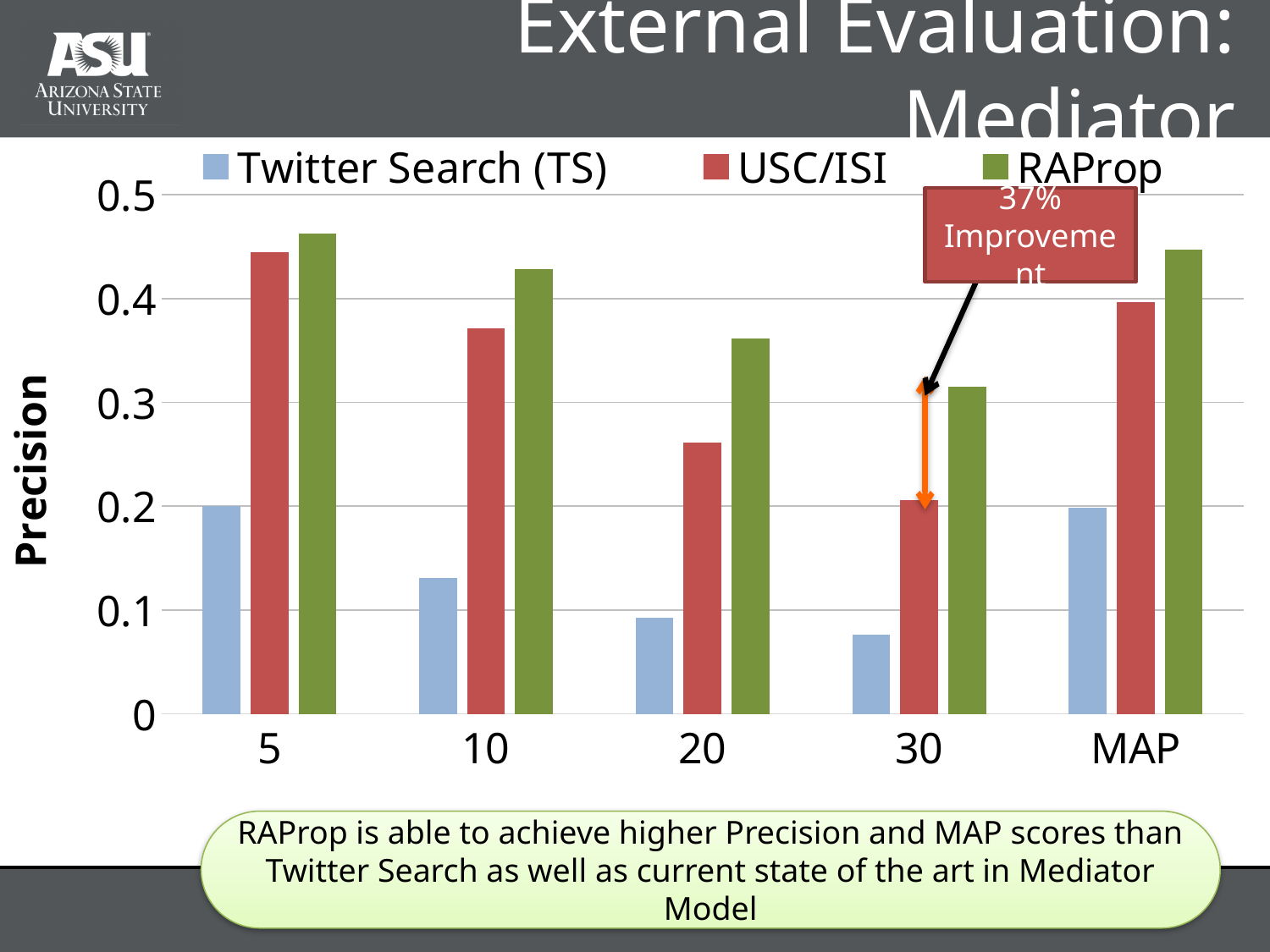
How many categories are shown along the x axis? 5 At which category is the Twitter Search (TS) bar lowest? 30 Which series has the lowest bar in the 20 category? Twitter Search (TS) Is the Twitter Search (TS) value at 30 greater or less than 0.1? less What is the label of the y axis? Precision Is the RAProp value at 20 greater or less than 0.3? greater Which series has the highest bar in the 10 category? RAProp How many series does the legend list? 3 What kind of chart is shown on the slide? bar chart Which is larger: the USC/ISI value at 20 or the RAProp value at 20? RAProp Do the Twitter Search (TS) values rise or fall from category 5 to category 30? fall Is the USC/ISI value at 10 greater or less than 0.4? less